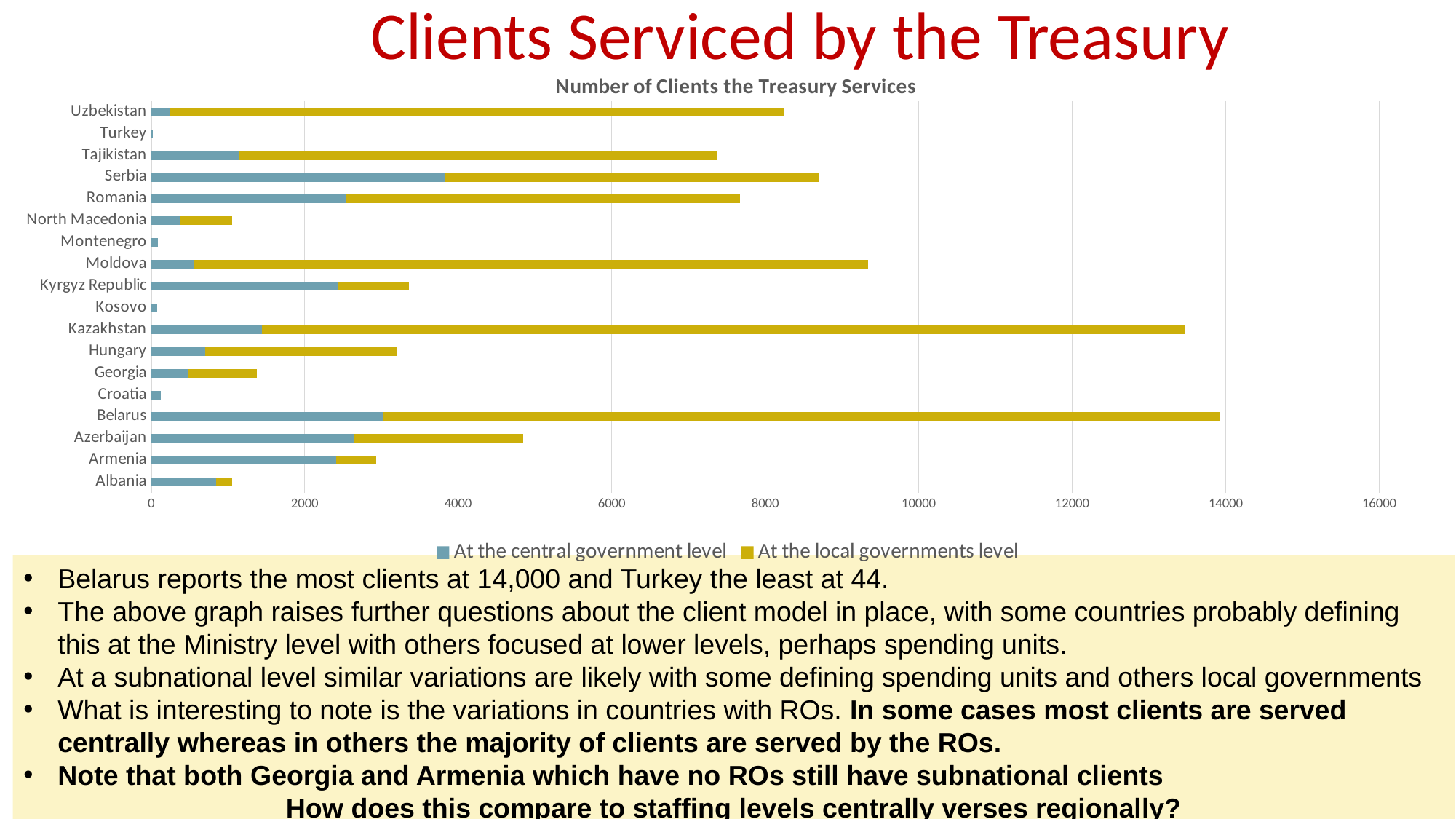
What kind of chart is shown on the slide? Stacked bar chart Which has a larger total number of clients, Serbia or Romania? Serbia Which country has the highest total number of clients on the chart? Belarus Is the total value for North Macedonia greater or less than 2000? less Is the total value for Serbia greater or less than 8000? greater How many series does the chart legend list? 2 Which has a larger value at the central government level, Serbia or Romania? Serbia How many countries are listed on the chart? 18 Is the total value for Kazakhstan greater or less than 12000? greater What is the title of the chart? Number of Clients the Treasury Services Which country has the lowest total number of clients on the chart? Turkey